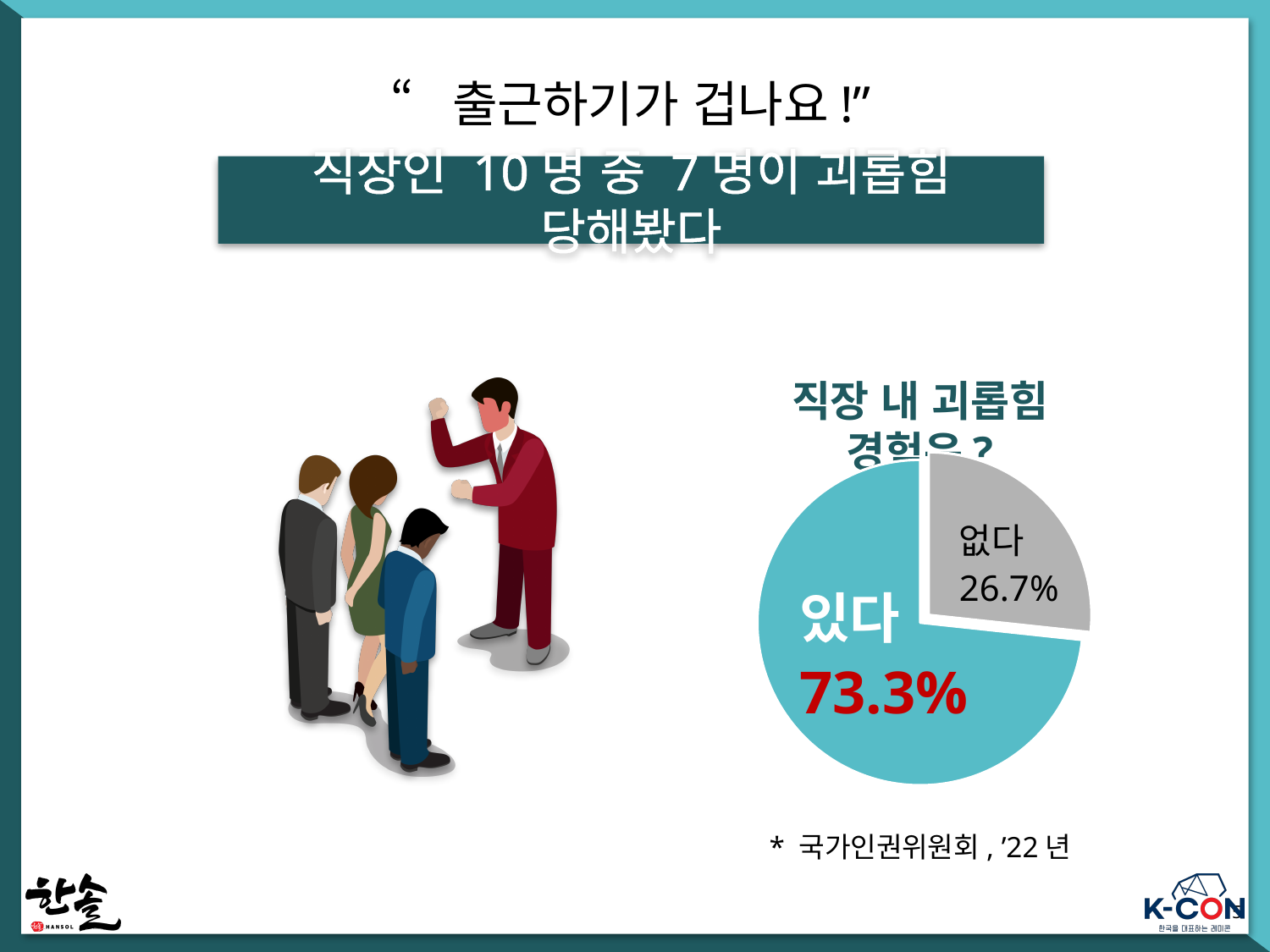
What is the value for 없다 in the pie chart? 26.7% What is the difference between the 있다 and 없다 shares in the pie chart? 46.6% What is the value for 있다 in the pie chart? 73.3% What colour is the 있다 slice in the pie chart? teal What share of the pie does the 없다 slice represent? 26.7% What source is cited below the pie chart? 국가인권위원회, '22년 Which slice of the pie chart is the smallest? 없다 How many slices does the pie chart have? 2 What kind of chart is shown on the slide? pie chart Which slice of the pie chart is the largest? 있다 Which is larger in the pie chart, 있다 or 없다? 있다